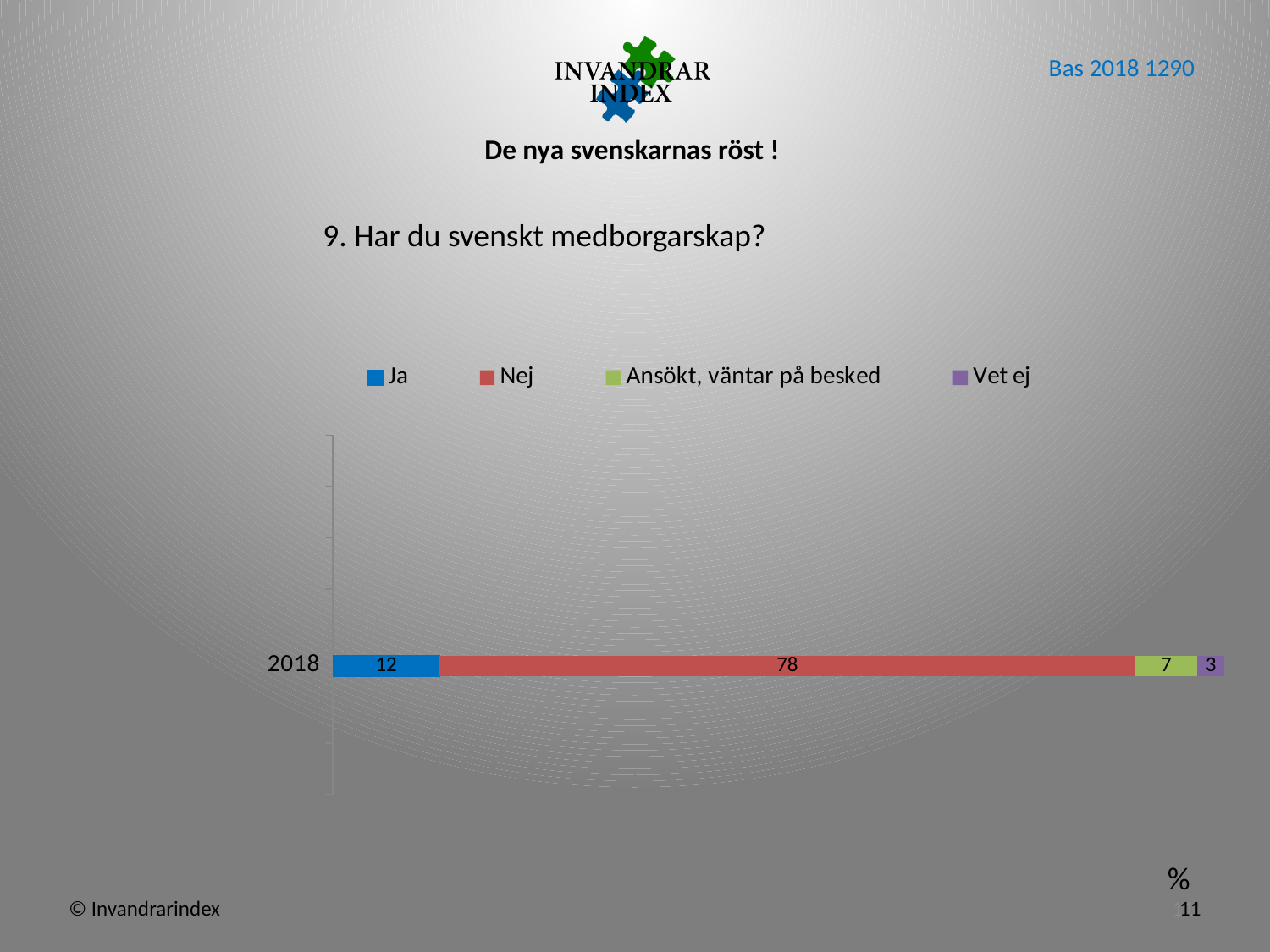
What is the total of the stacked bar for 2018? 100 What is the difference between the values for "Nej" and "Ja"? 66 Which is larger, the value for "Ja" or the value for "Ansökt, väntar på besked"? Ja How many series does the legend list? 4 What is the value for "Ja" in the 2018 bar? 12 What is the value for "Ansökt, väntar på besked" in the 2018 bar? 7 Which series has the lowest value in the 2018 bar? Vet ej What colour represents "Nej" in the chart? Red What is the value for "Vet ej" in the 2018 bar? 3 Which series has the highest value in the 2018 bar? Nej What is the value for "Nej" in the 2018 bar? 78 What kind of chart is shown on the slide? Stacked bar chart